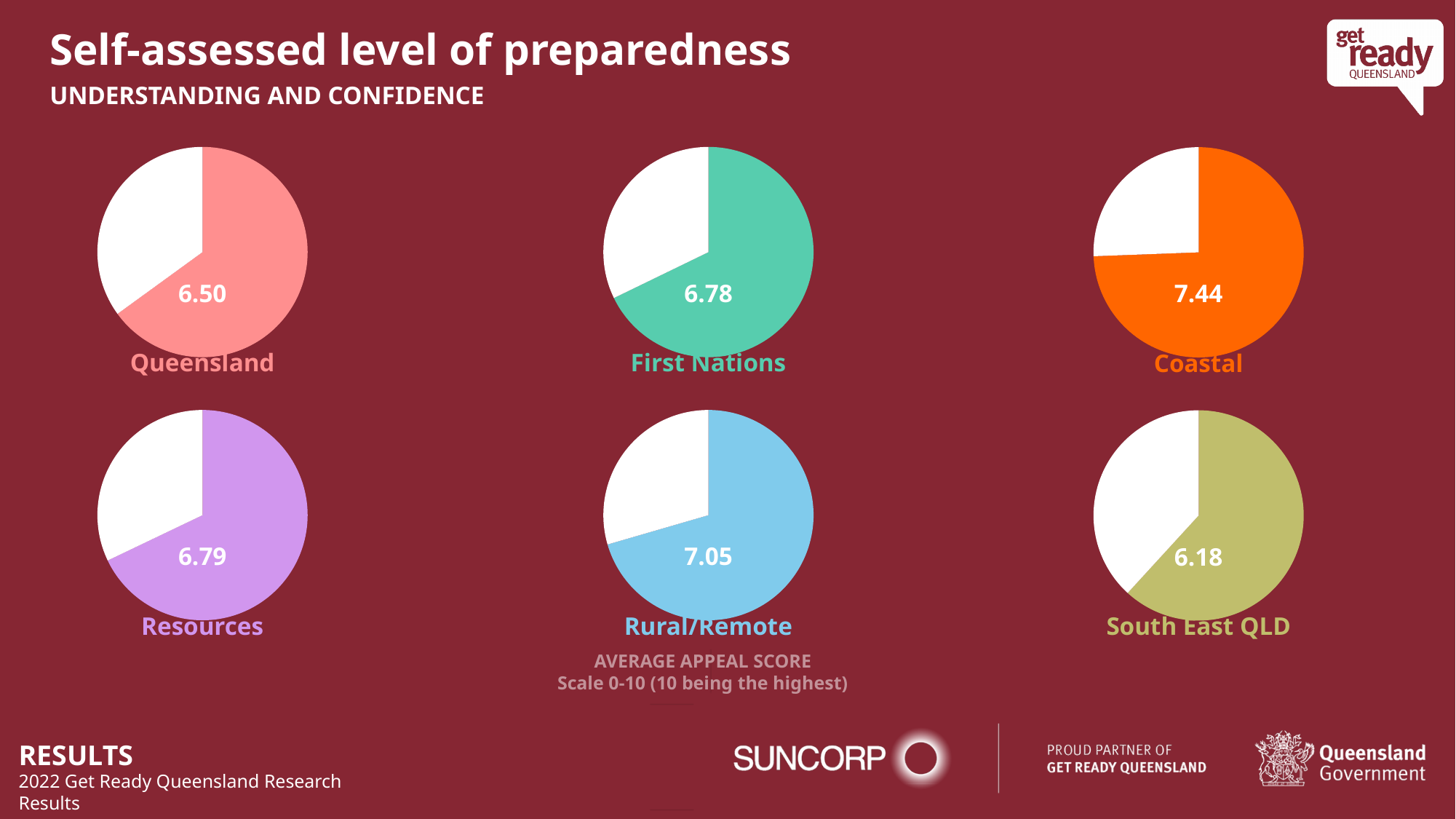
What score is shown for South East QLD? 6.18 What score is shown in the Coastal pie chart? 7.44 What is the self-assessed preparedness score shown for Queensland? 6.50 What is the value shown for Rural/Remote? 7.05 How many pie charts are shown on the slide? 6 What is the difference between the Coastal score and the Queensland score? 0.94 What kind of chart is used to show each group's score? Pie chart What is the difference between the Rural/Remote score and the South East QLD score? 0.87 Which has a higher score, Rural/Remote or Queensland? Rural/Remote What scale are the average appeal scores measured on? 0-10 (10 being the highest) Which group has the lowest self-assessed preparedness score? South East QLD Which group has the highest self-assessed preparedness score? Coastal